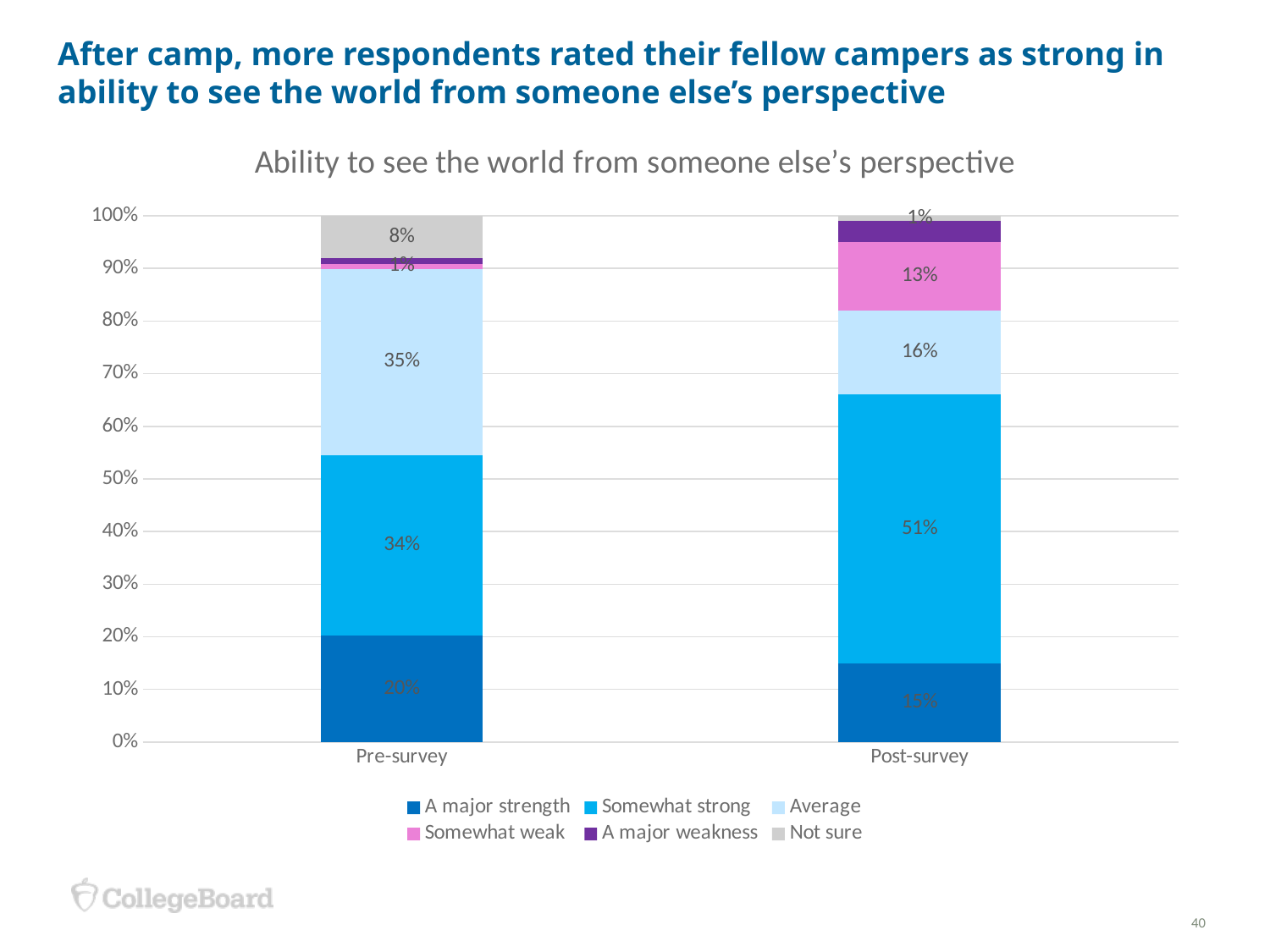
Which survey has the larger 'Average' share, Pre-survey or Post-survey? Pre-survey Which survey has the larger 'A major strength' share, Pre-survey or Post-survey? Pre-survey What kind of chart is shown on the slide? Stacked bar chart What is the title of the chart? Ability to see the world from someone else's perspective How many series does the legend list? 6 What percentage of Post-survey respondents rated the ability as 'Somewhat strong'? 51% What is the 'Somewhat weak' value for Post-survey? 13% How many categories are shown on the x axis? 2 What is the 'Not sure' value for Pre-survey? 8% By how many percentage points did 'Somewhat strong' increase from Pre-survey to Post-survey? 17 percentage points What is the 'A major strength' value for Post-survey? 15% What is the 'Average' value for Pre-survey? 35%